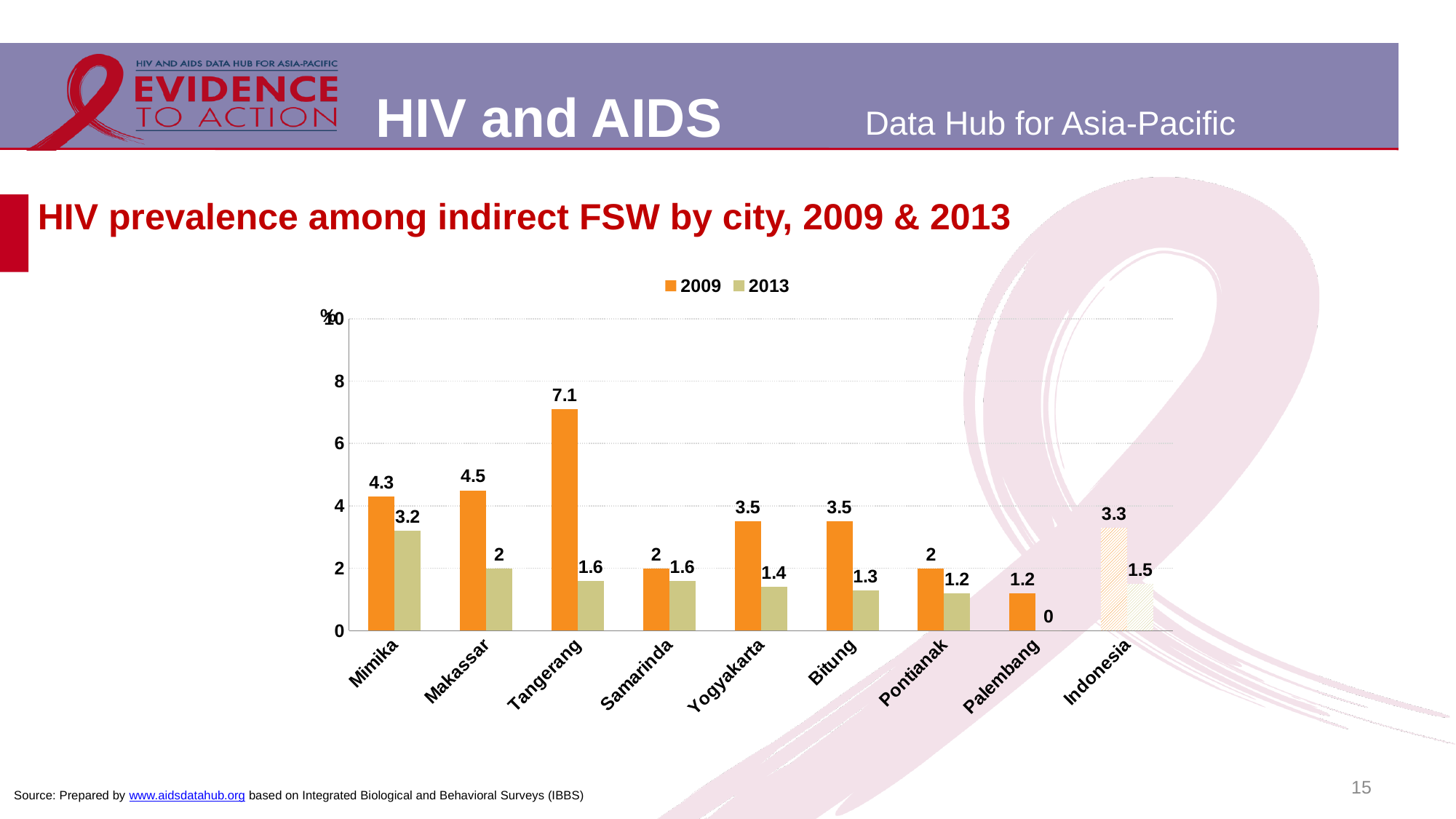
Which is larger for Makassar: the 2009 value or the 2013 value? 2009 How many categories are shown on the x axis? 9 Which category has the lowest 2013 value? Palembang Is the 2009 value for Mimika greater or less than 4? greater How many series does the legend list? 2 What kind of chart is shown on the slide? bar chart What is the 2013 value for Palembang? 0 Which city has the highest 2009 value? Tangerang What is the 2009 HIV prevalence value for Tangerang? 7.1 What is the title of the chart? HIV prevalence among indirect FSW by city, 2009 & 2013 What is the difference between the 2009 and 2013 values for Tangerang? 5.5 What is the 2013 HIV prevalence value for Mimika? 3.2